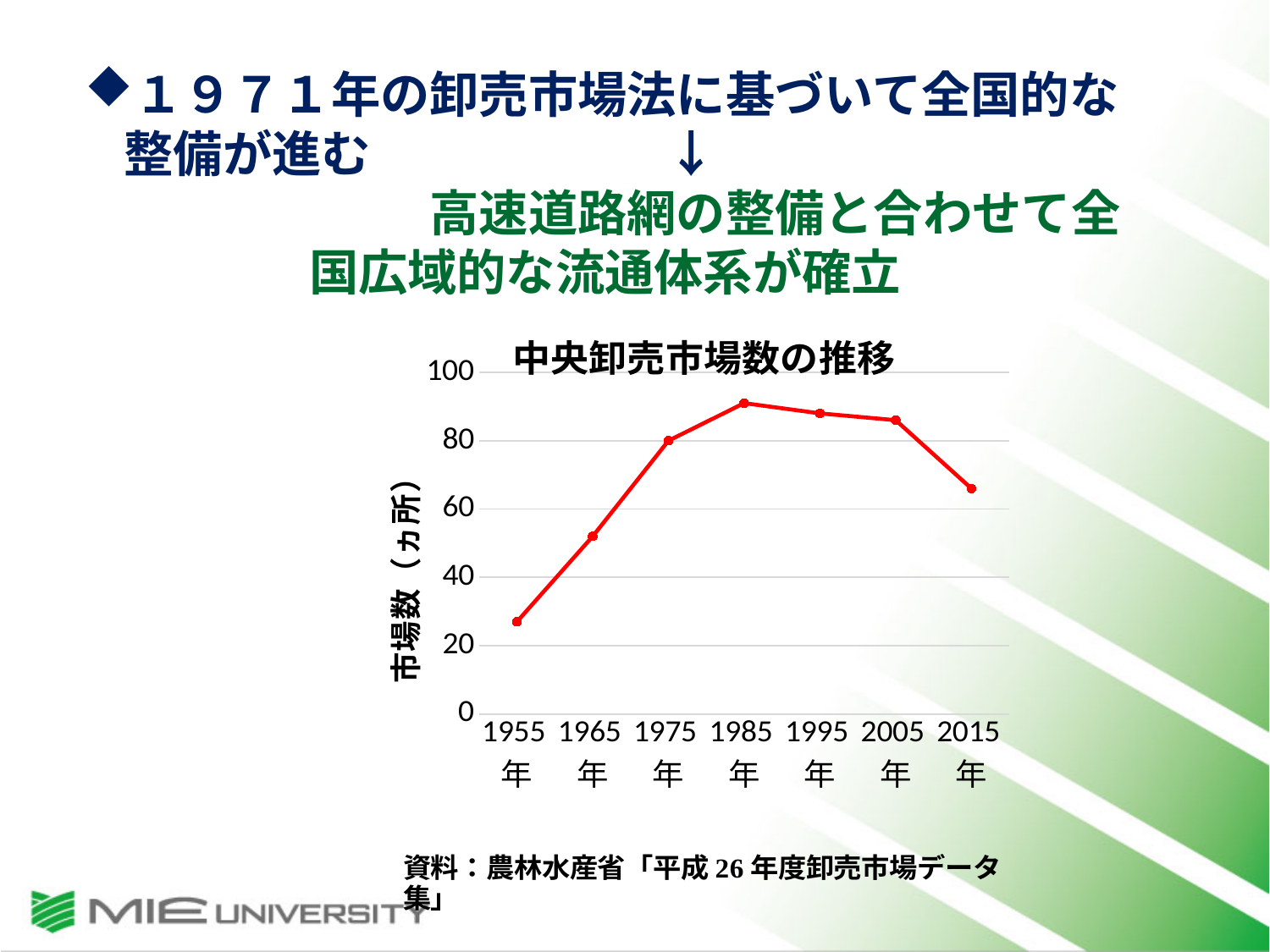
Is the value for 1955年 greater or less than 40? less What kind of chart is shown on the slide? line chart Do the values rise or fall from 1955年 to 1985年? rise Which year has the highest number of markets on the chart? 1985年 Which year has the lowest number of markets on the chart? 1955年 Is the value for 2015年 greater or less than 80? less Is the value for 1965年 greater or less than 40? greater Which is larger, the value for 1965年 or the value for 2015年? 2015年 How many data points are plotted on the chart? 7 What is the title of the chart? 中央卸売市場数の推移 What is the label of the vertical axis of the chart? 市場数（ヵ所）